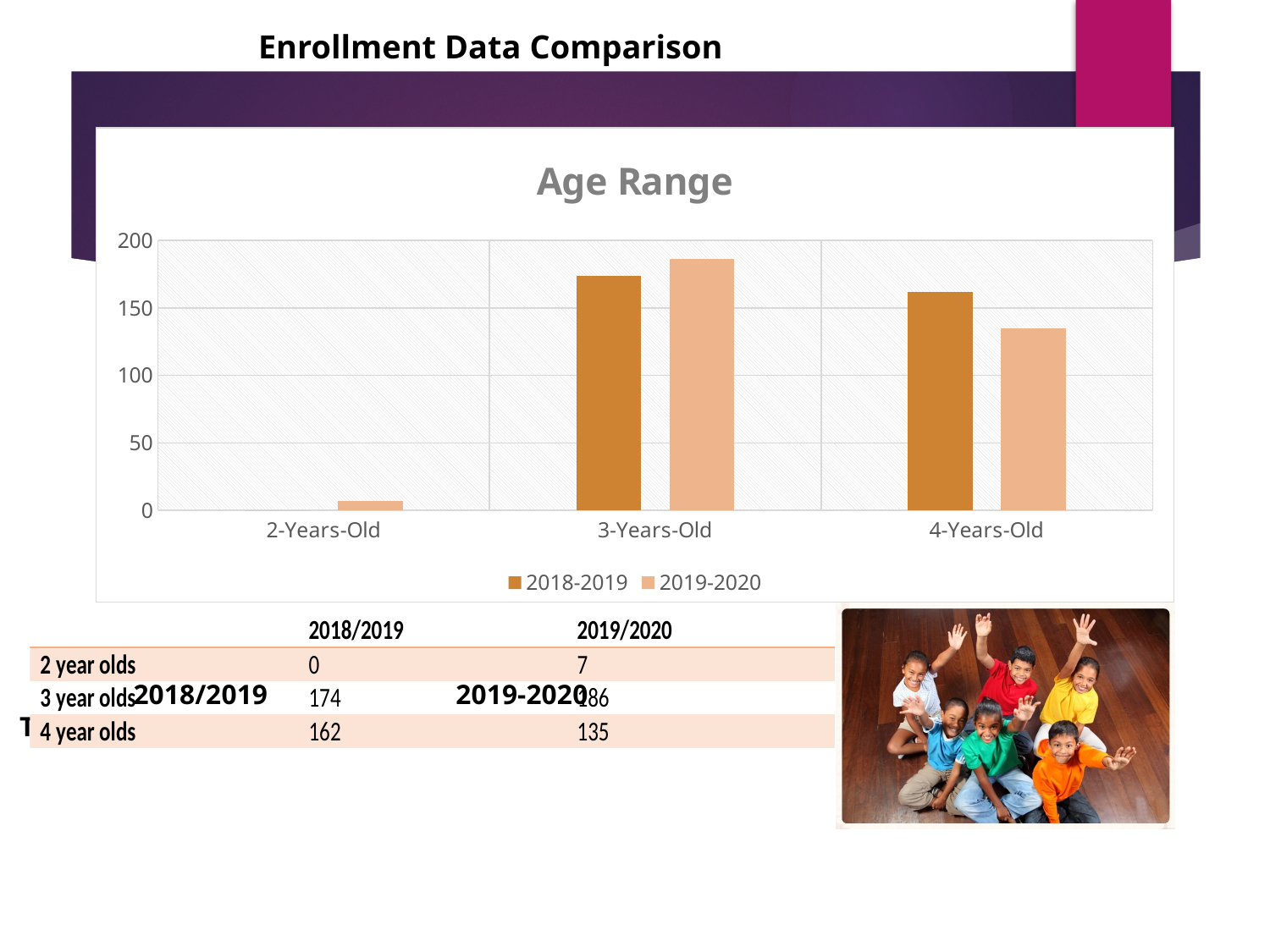
What is the 2019-2020 value for 4-Years-Old? 135 What type of chart is shown on the slide? bar chart What is the difference between the 2018-2019 and 2019-2020 values for 4-Years-Old? 27 What is the 2018-2019 value for 3-Years-Old? 174 What is the title of the chart? Age Range For 4-Years-Old, which series is larger, 2018-2019 or 2019-2020? 2018-2019 How many age categories are shown on the x axis of the chart? 3 What is the 2019-2020 value for 2-Years-Old? 7 What is the 2018-2019 value for 4-Years-Old? 162 Which age category has the highest 2018-2019 value? 3-Years-Old How many series does the chart legend list? 2 Which age category has the lowest 2019-2020 value? 2-Years-Old